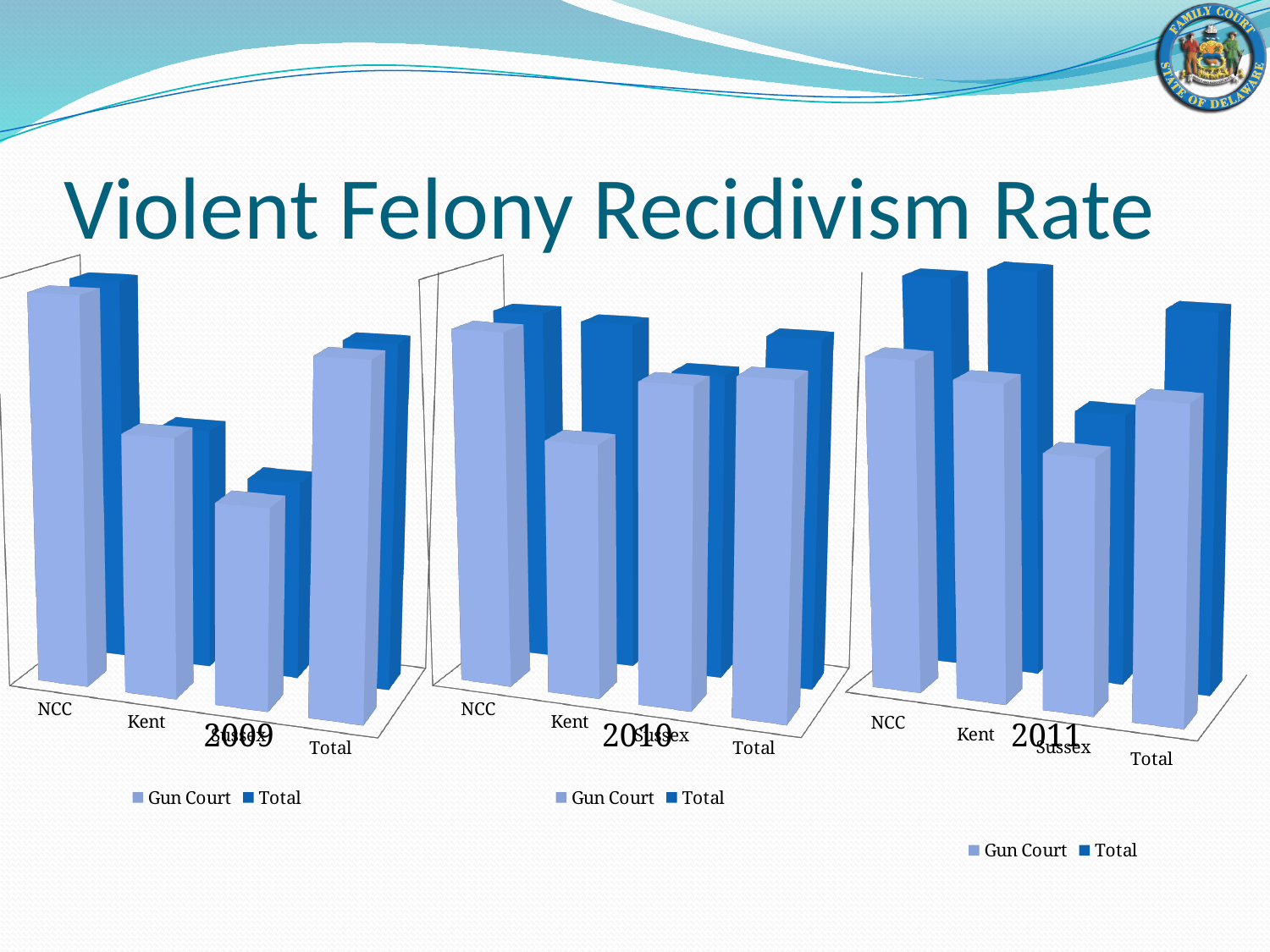
What kind of chart is the 2009 chart? Bar chart How many series does the legend of the 2010 chart list? 2 In the 2011 chart, which category has the lowest Gun Court value? Sussex In the 2010 chart, which category has the lowest Gun Court value? Kent How many categories are shown on the x axis of the 2011 chart? 4 What are the two series named in the legend of the 2009 chart? Gun Court and Total In the 2009 chart, which category has the highest Gun Court value? NCC In the 2010 chart, which category has the highest Gun Court value? NCC In the 2011 chart, which category has the larger Gun Court value, NCC or Kent? NCC In the 2009 chart, which is larger for Kent: the Gun Court value or the Total value? Gun Court In the 2011 chart, which category has the lowest value for the Total series? Sussex